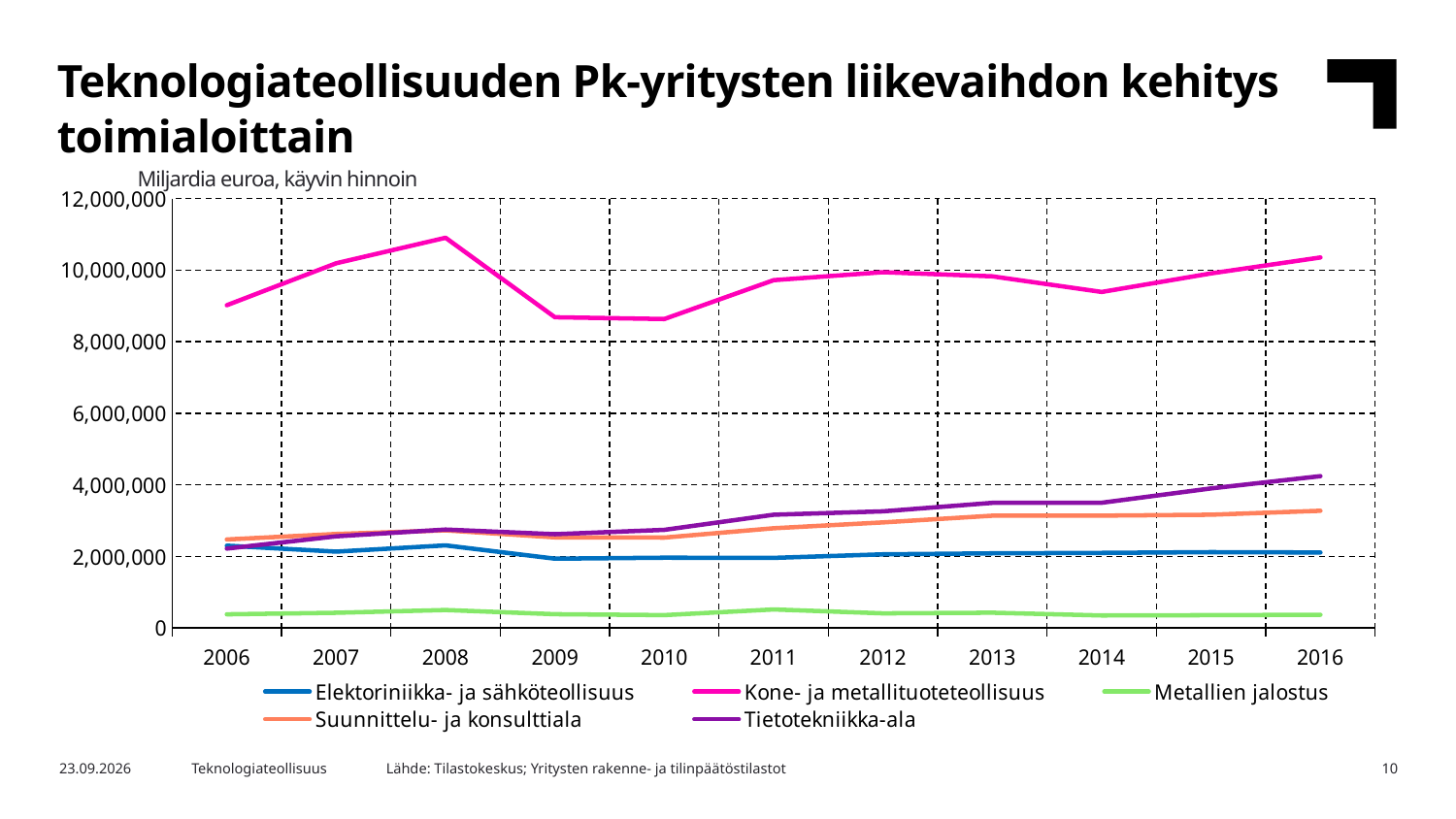
Is the value for Kone- ja metallituoteteollisuus in 2008 greater or less than 10,000,000? greater Does the Tietotekniikka-ala line generally rise or fall from 2006 to 2016? rise How many years are plotted along the x axis? 11 Which series has the highest value in 2016? Kone- ja metallituoteteollisuus Which series has the lowest value in 2016? Metallien jalostus How many series does the legend list? 5 Is the value for Metallien jalostus in 2011 greater or less than 2,000,000? less In 2016, which is larger: Tietotekniikka-ala or Suunnittelu- ja konsulttiala? Tietotekniikka-ala In which year does Kone- ja metallituoteteollisuus reach its highest value? 2008 What kind of chart is shown on the slide? line chart Is the value for Kone- ja metallituoteteollisuus in 2009 greater or less than 10,000,000? less